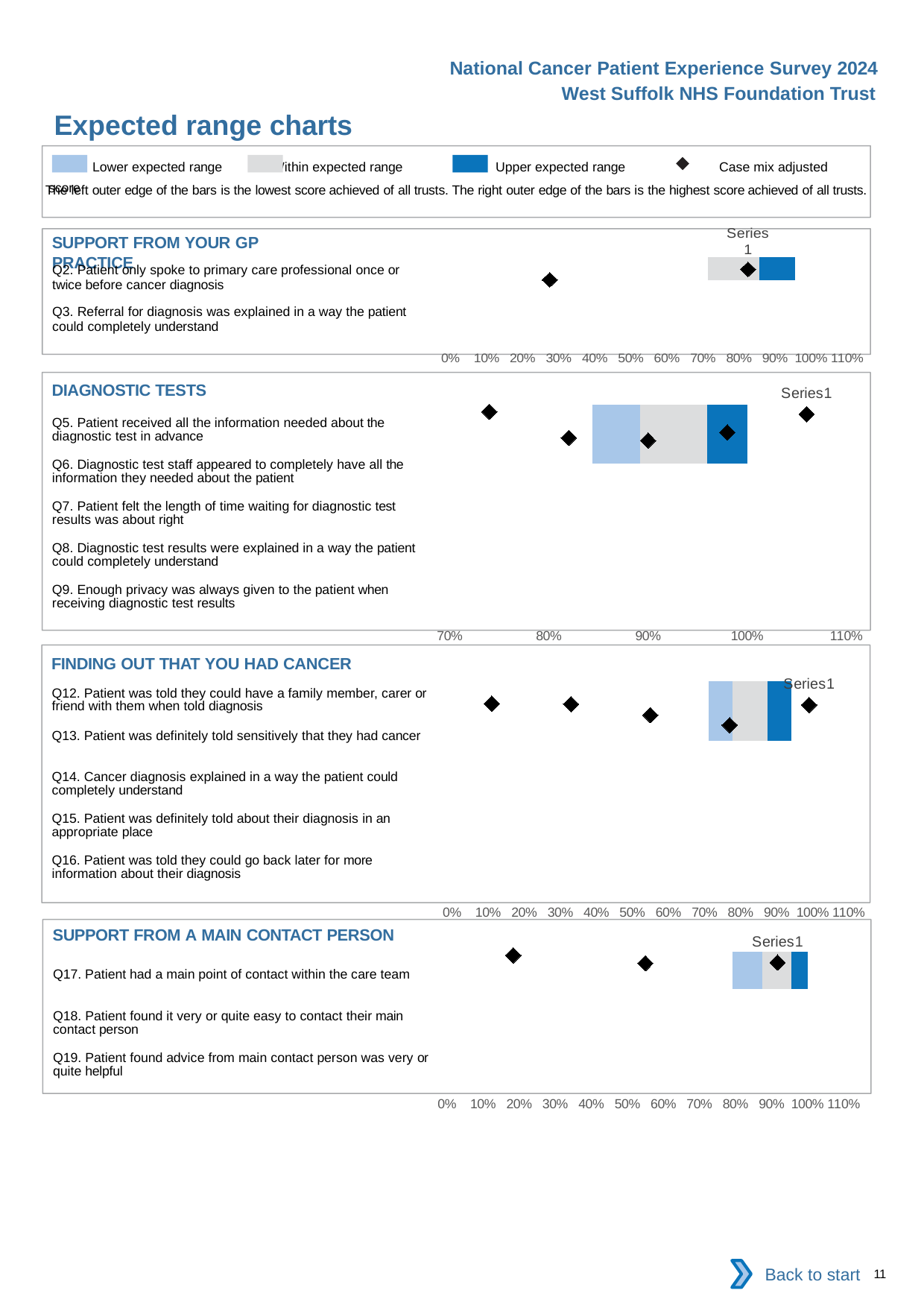
In the "DIAGNOSTIC TESTS" chart, is the rightmost diamond marker greater or less than 100%? greater What is the lowest tick label on the x axis of the "DIAGNOSTIC TESTS" chart? 70% In the "SUPPORT FROM YOUR GP PRACTICE" chart, how many diamond markers are plotted? 2 In the "SUPPORT FROM A MAIN CONTACT PERSON" chart, how many diamond markers are plotted? 3 In the "SUPPORT FROM A MAIN CONTACT PERSON" chart, is the rightmost diamond marker greater or less than 80%? greater What kind of chart is the "SUPPORT FROM YOUR GP PRACTICE" chart? bar chart In the "FINDING OUT THAT YOU HAD CANCER" chart, is the leftmost diamond marker greater or less than 20%? less In the "FINDING OUT THAT YOU HAD CANCER" chart, how many diamond markers are plotted? 5